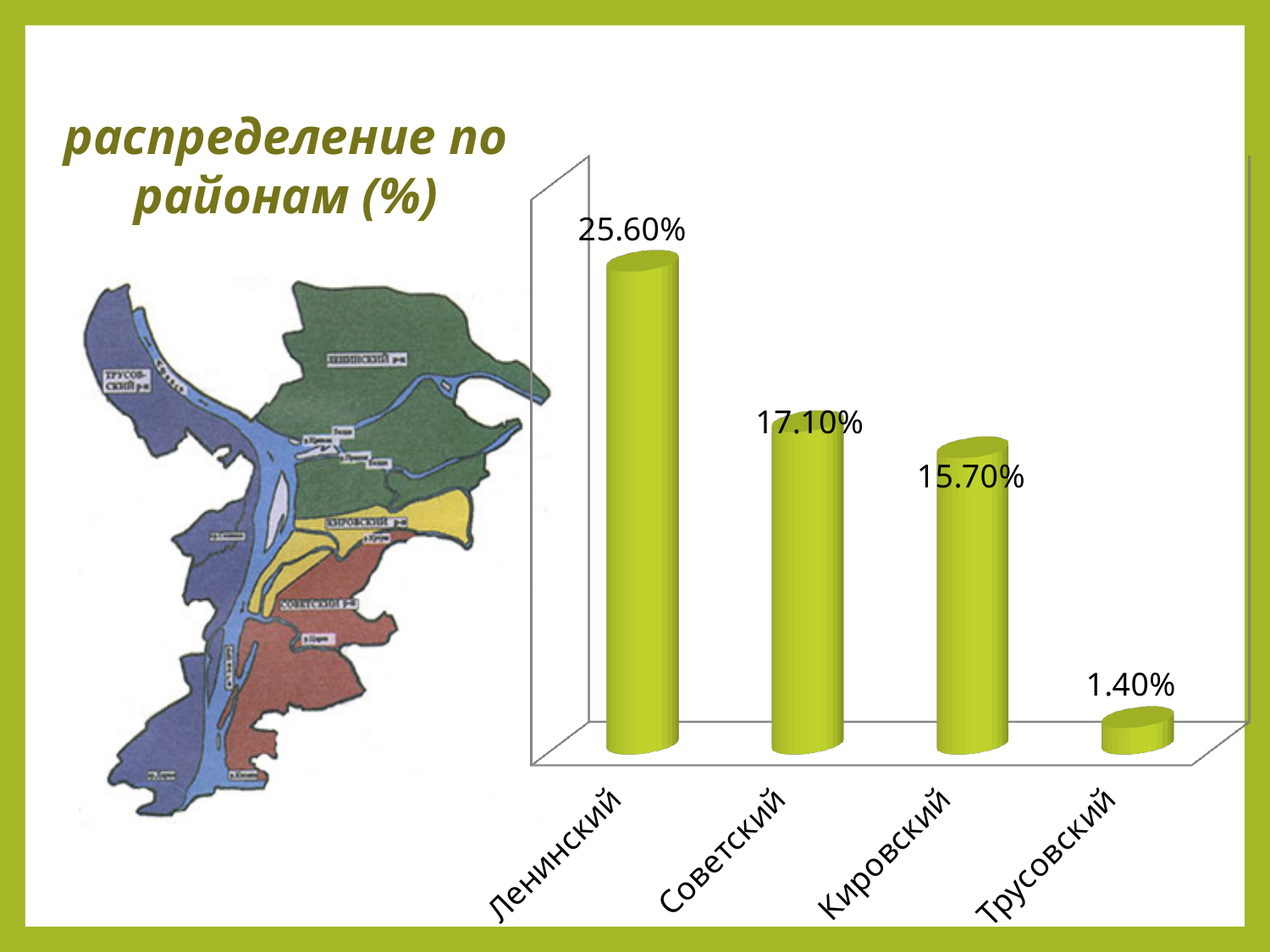
Which district has the lowest value? Трусовский What is the value for Советский? 17.10% Do the values rise or fall from left to right along the x axis? fall How many districts are shown in the chart? 4 Which district has the highest value? Ленинский What is the value for Трусовский? 1.40% What is the difference between the values for Ленинский and Советский? 8.50% Which is larger, the value for Советский or the value for Кировский? Советский What is the value for Ленинский? 25.60% What is the difference between the values for Кировский and Трусовский? 14.30% What is the value for Кировский? 15.70% What kind of chart is shown on the slide? bar chart